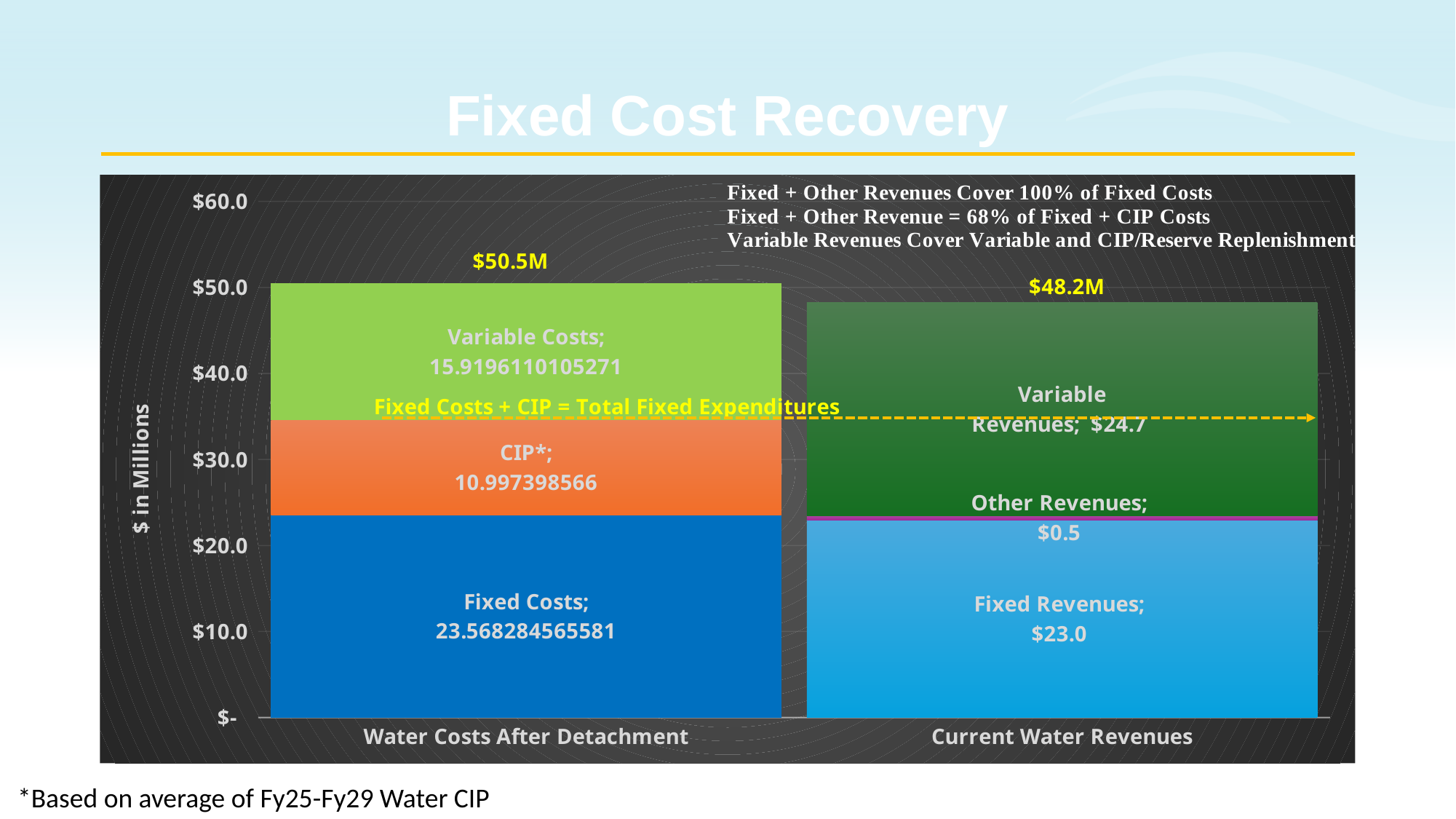
What is the total labelled for the Water Costs After Detachment bar? $50.5M What is the value of Fixed Revenues in the Current Water Revenues bar? $23.0 Which bar has the larger total, Water Costs After Detachment or Current Water Revenues? Water Costs After Detachment What is the value of Variable Revenues in the Current Water Revenues bar? $24.7 How many categories are shown on the x axis? 2 What is the value of Other Revenues in the Current Water Revenues bar? $0.5 What is the value of Variable Costs in the Water Costs After Detachment bar? 15.9196110105271 What is the value of CIP* in the Water Costs After Detachment bar? 10.997398566 What is the total labelled for the Current Water Revenues bar? $48.2M What is the label of the y axis? $ in Millions What is the value of Fixed Costs in the Water Costs After Detachment bar? 23.568284565581 What type of chart is shown on the slide? stacked bar chart